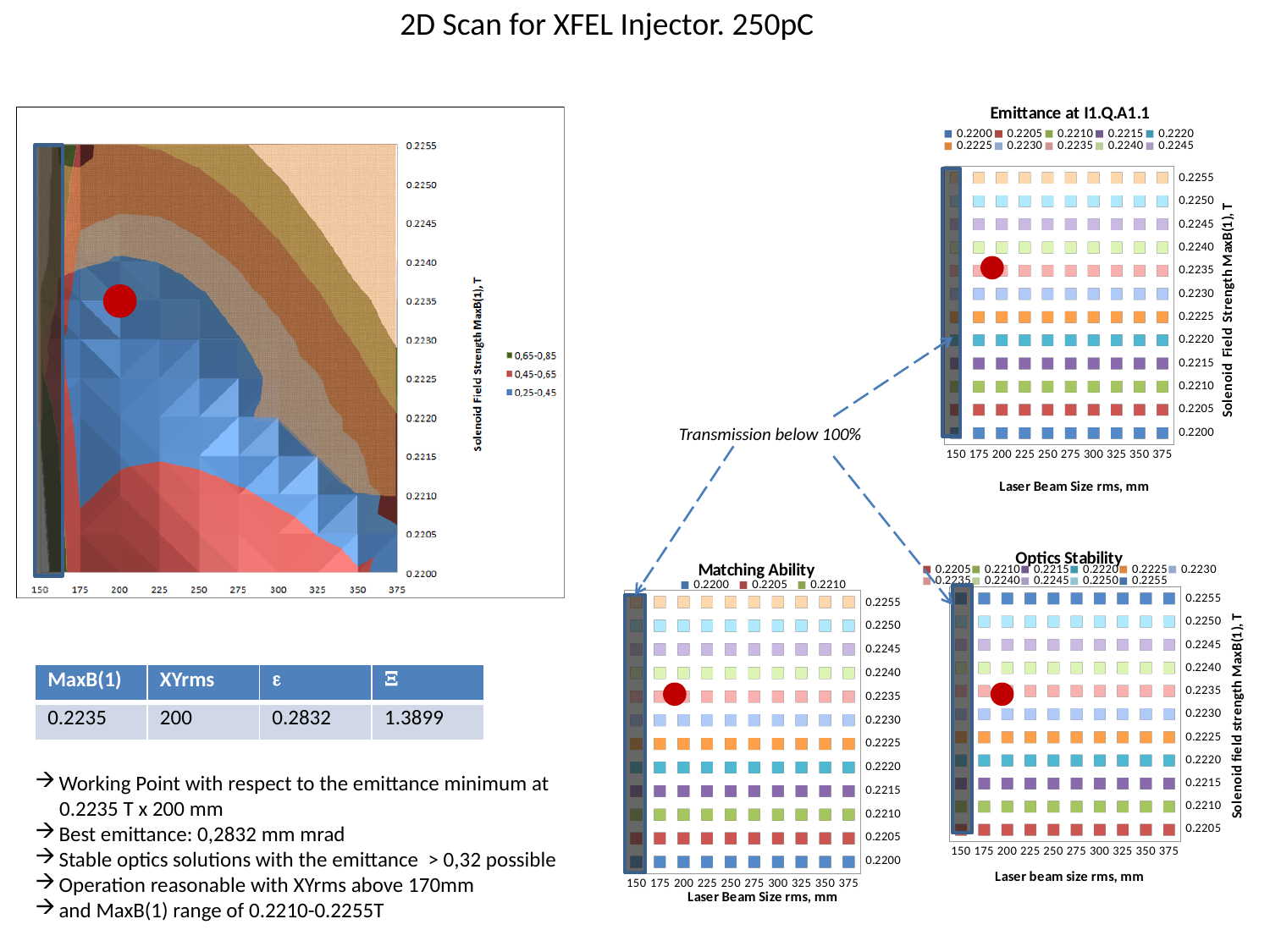
What is the highest y-axis tick value on the 'Emittance at I1.Q.A1.1' chart? 0.2255 How many series does the legend of the 'Emittance at I1.Q.A1.1' chart list? 10 What is the lowest y-axis tick value on the 'Optics Stability' chart? 0.2205 What is the y-axis label of the 'Optics Stability' chart? Solenoid field strength MaxB(1), T What is the x-axis label of the 'Emittance at I1.Q.A1.1' chart? Laser Beam Size rms, mm How many series does the legend of the 'Matching Ability' chart list? 3 Which legend entry of the contour chart on the left covers the highest range of values? 0,65-0,85 What is the highest x-axis tick value on the contour chart on the left of the slide? 375 What is the lowest x-axis tick value on the 'Optics Stability' chart? 150 How many series does the legend of the contour chart on the left of the slide list? 3 How many x-axis tick labels (laser beam sizes) are shown on the 'Matching Ability' chart? 10